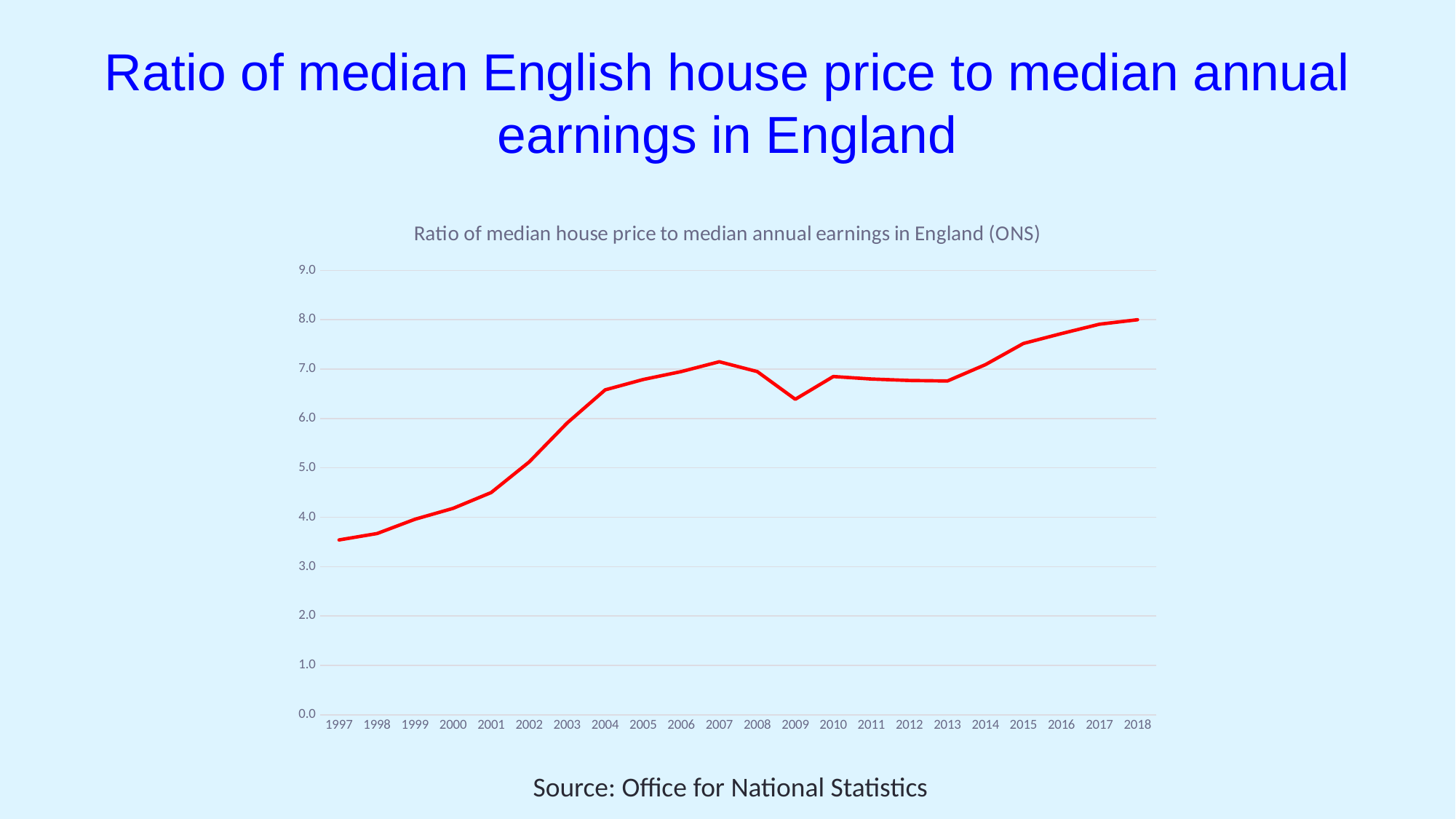
Overall, does the ratio rise or fall from 1997 to 2018? Rise Which year has the lowest ratio of median house price to median annual earnings? 1997 How many years are plotted along the x axis? 22 Which year has the larger ratio, 2007 or 2009? 2007 Which year has the larger ratio, 2013 or 2015? 2015 Is the value for 1997 greater or less than 4.0? less Which year has the highest ratio of median house price to median annual earnings? 2018 What colour is the plotted line? Red Is the value for 2018 greater or less than 7.0? greater Is the value for 2002 greater or less than 6.0? less What kind of chart is shown on the slide? Line chart